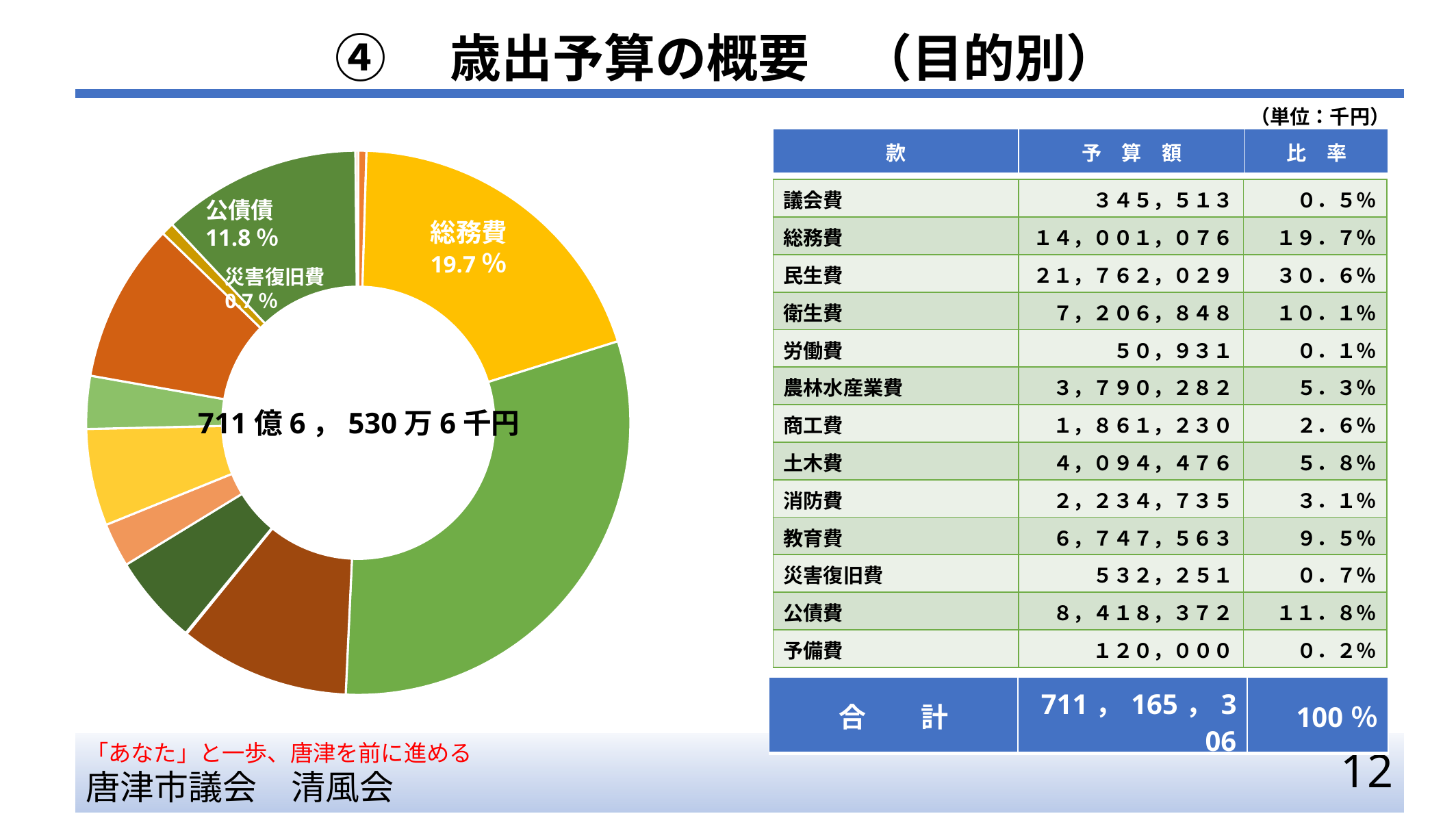
What percentage share is labelled for 公債費 on the pie chart? 11.8% How many expenditure categories (款) are listed in the table? 13 Which is larger, the share for 総務費 or the share for 公債費? 総務費 What is the budget amount (予算額) for 教育費? 6,747,563 Which category has the smallest share of the expenditure budget? 労働費 Which category has the largest share of the expenditure budget? 民生費 What percentage share is labelled for 災害復旧費 on the pie chart? 0.7% What total amount is written in the centre of the pie chart? 711億6，530万6千円 What is the difference in percentage points between the share for 総務費 and the share for 公債費? 7.9 What percentage share is labelled for 総務費 on the pie chart? 19.7% What kind of chart is shown on the left of the slide? doughnut chart What is the budget amount (予算額) for 民生費? 21,762,029